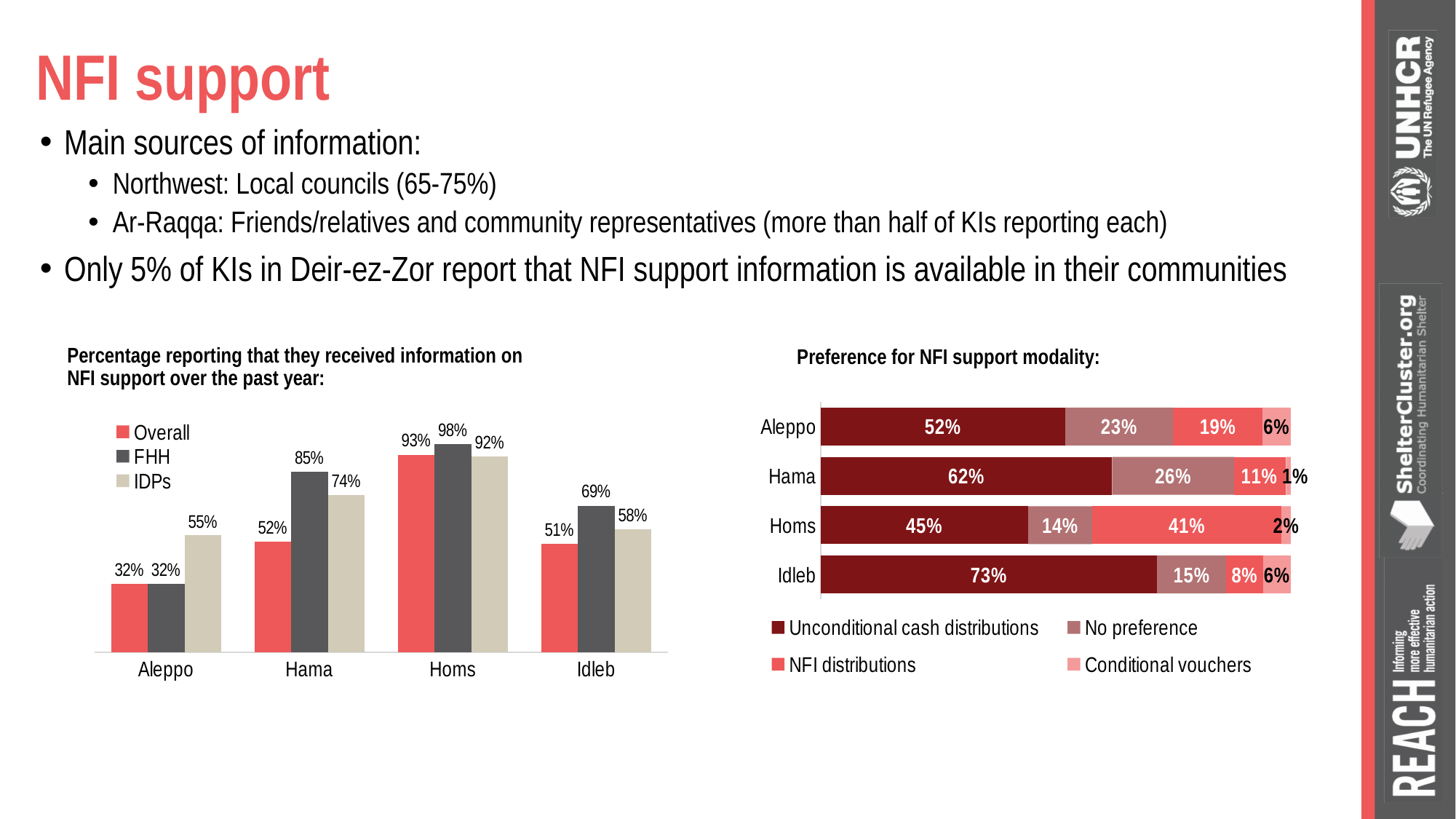
In the chart 'Percentage reporting that they received information on NFI support over the past year', what is the IDPs value for Aleppo? 55% In the chart 'Percentage reporting that they received information on NFI support over the past year', what is the FHH value for Hama? 85% In the chart 'Preference for NFI support modality', is the conditional vouchers value for Aleppo larger or smaller than that for Hama? larger What type of chart is 'Preference for NFI support modality'? Stacked bar chart In the chart 'Percentage reporting that they received information on NFI support over the past year', what is the difference between the FHH and Overall values for Hama? 33% In the chart 'Preference for NFI support modality', which governorate has the highest share for unconditional cash distributions? Idleb In the chart 'Percentage reporting that they received information on NFI support over the past year', which governorate has the highest Overall value? Homs In the chart 'Preference for NFI support modality', what is the NFI distributions value for Homs? 41% In the chart 'Preference for NFI support modality', what percentage of Idleb prefers unconditional cash distributions? 73% In the chart 'Percentage reporting that they received information on NFI support over the past year', which governorate has the lowest FHH value? Aleppo In the chart 'Preference for NFI support modality', how many governorates are shown? 4 In the chart 'Percentage reporting that they received information on NFI support over the past year', how many series does the legend list? 3